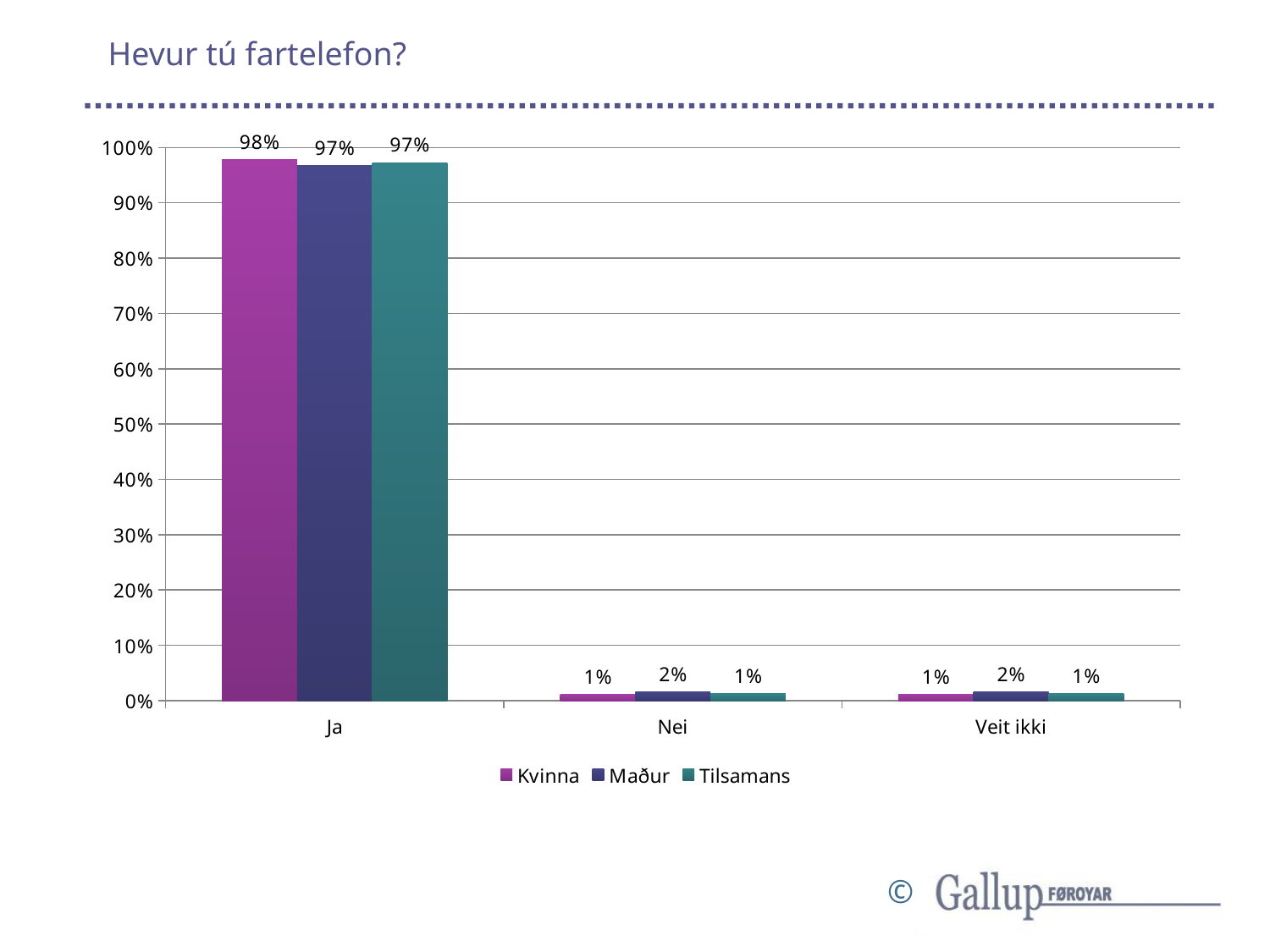
What kind of chart is shown on the slide? bar chart What is the value for Tilsamans in the Veit ikki category? 1% What is the value for Maður in the Ja category? 97% How many categories are shown on the x axis? 3 Which is larger: the Kvinna value for Ja or the Maður value for Ja? Kvinna Is the value for Tilsamans in the Ja category greater or less than 90%? greater What is the difference between the Kvinna value for Ja and the Kvinna value for Nei? 97% What is the value for Kvinna in the Ja category? 98% What is the value for Maður in the Nei category? 2% What is the title of the slide? Hevur tú fartelefon? How many series does the legend list? 3 Which category has the highest value for Kvinna? Ja